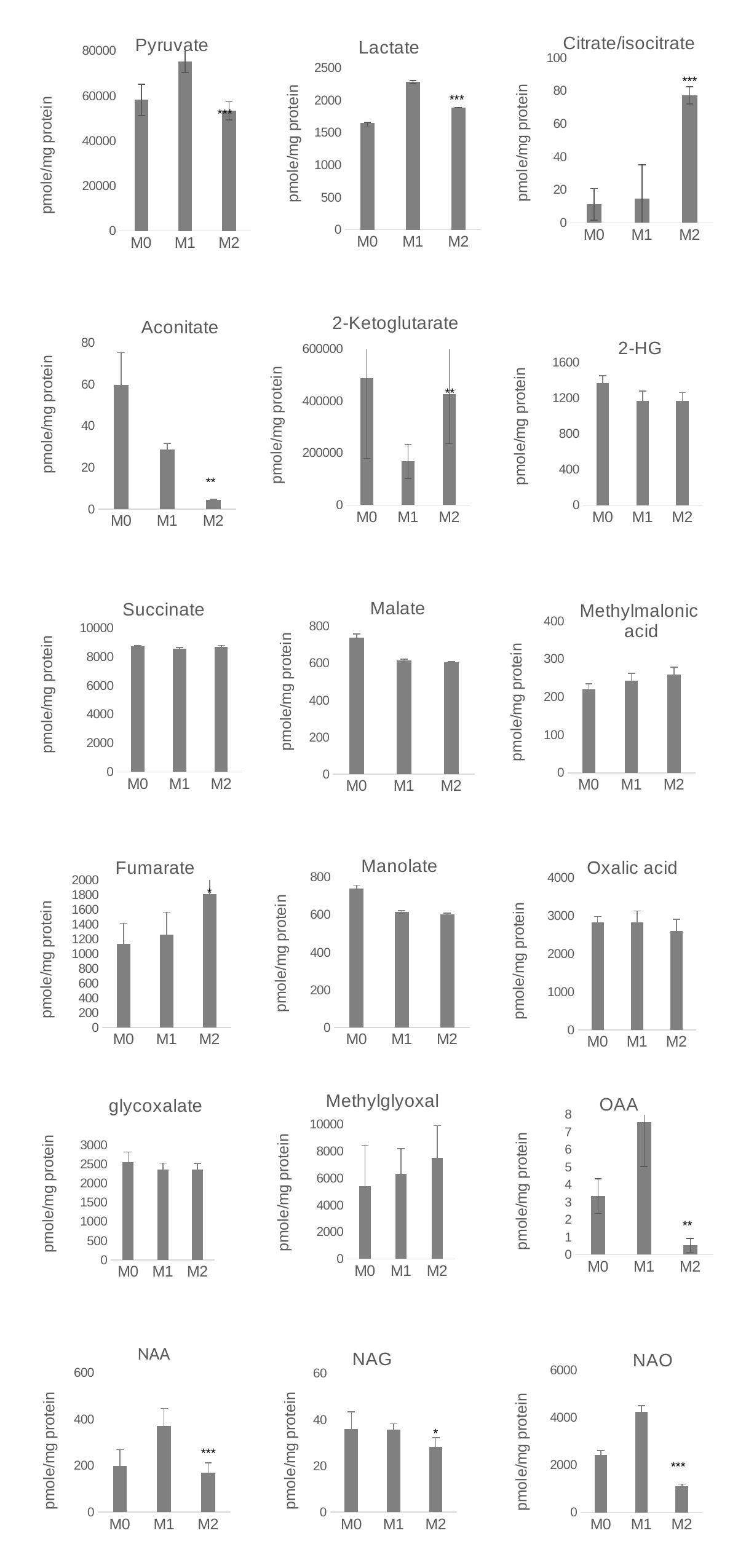
In the NAA chart, which category has the lowest value? M2 In the NAO chart, is the value for M2 greater or less than 2000? less In the Methylmalonic acid chart, do the values rise or fall from M0 to M2? rise In the Lactate chart, is the value for M0 greater or less than 2000? less In the OAA chart, which is larger, the value for M1 or the value for M2? M1 In the 2-Ketoglutarate chart, which category has the lowest value? M1 What kind of chart is the Succinate chart? bar chart In the Malate chart, is the value for M0 greater or less than 600? greater In the Pyruvate chart, which category has the highest value? M1 How many categories are shown on the x axis of the Fumarate chart? 3 In the Citrate/isocitrate chart, which category has the highest value? M2 In the Aconitate chart, do the values rise or fall from M0 to M2? fall